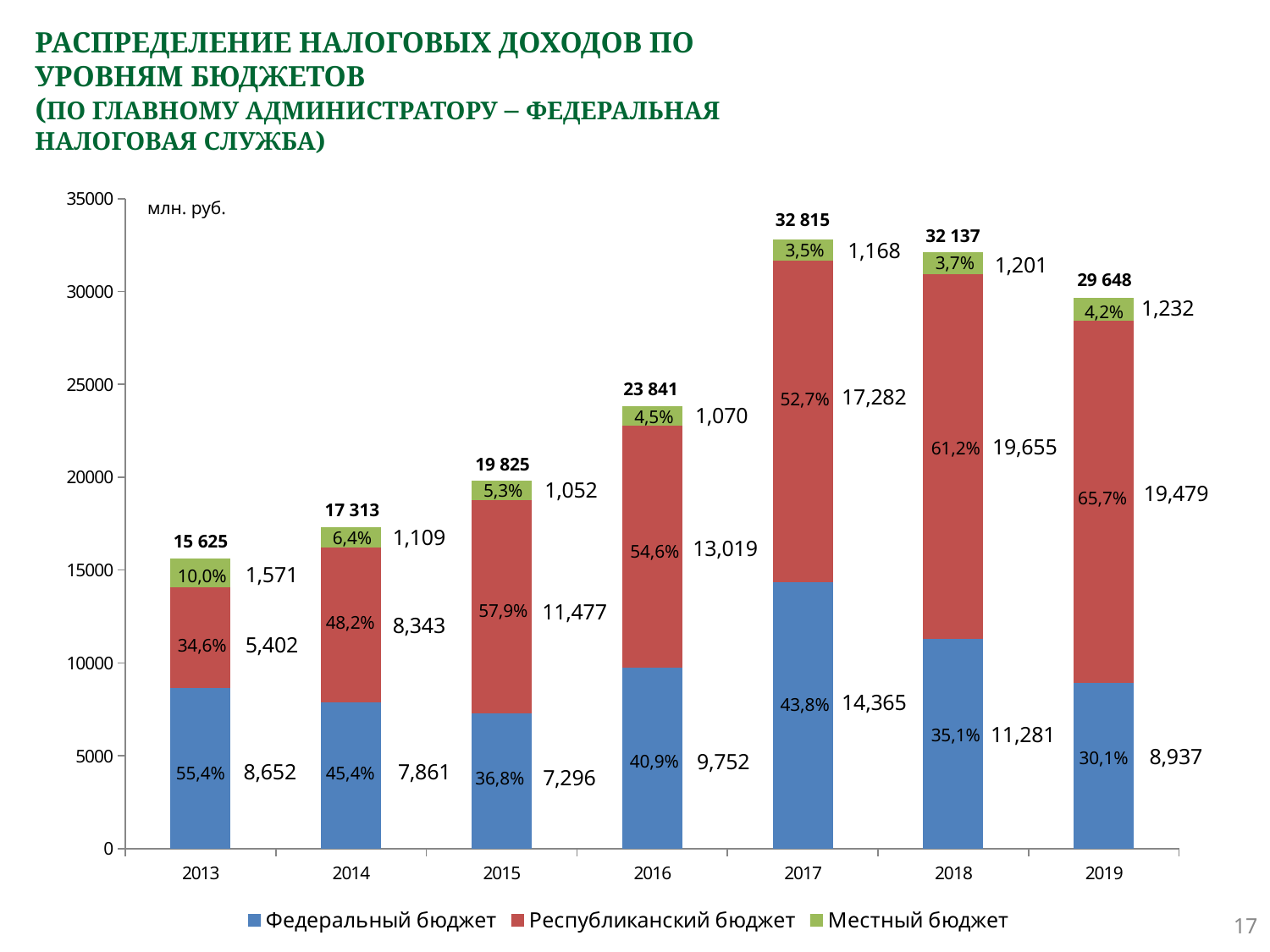
How many years are shown on the x axis? 7 What is the total tax revenue shown above the bar for 2017? 32 815 What is the value for Федеральный бюджет in 2019? 8,937 What is the value for Местный бюджет in 2016? 1,070 Which is larger in 2014: Федеральный бюджет or Республиканский бюджет? Республиканский бюджет Which year has the lowest total tax revenue? 2013 What type of chart is shown on the slide? stacked bar chart Which year has the highest total tax revenue? 2017 What unit of measurement is indicated in the top-left corner of the chart? млн. руб. How many series does the legend list? 3 What share of the 2013 total does Республиканский бюджет account for? 34,6% What is the difference between the Республиканский бюджет values in 2018 and 2019? 176